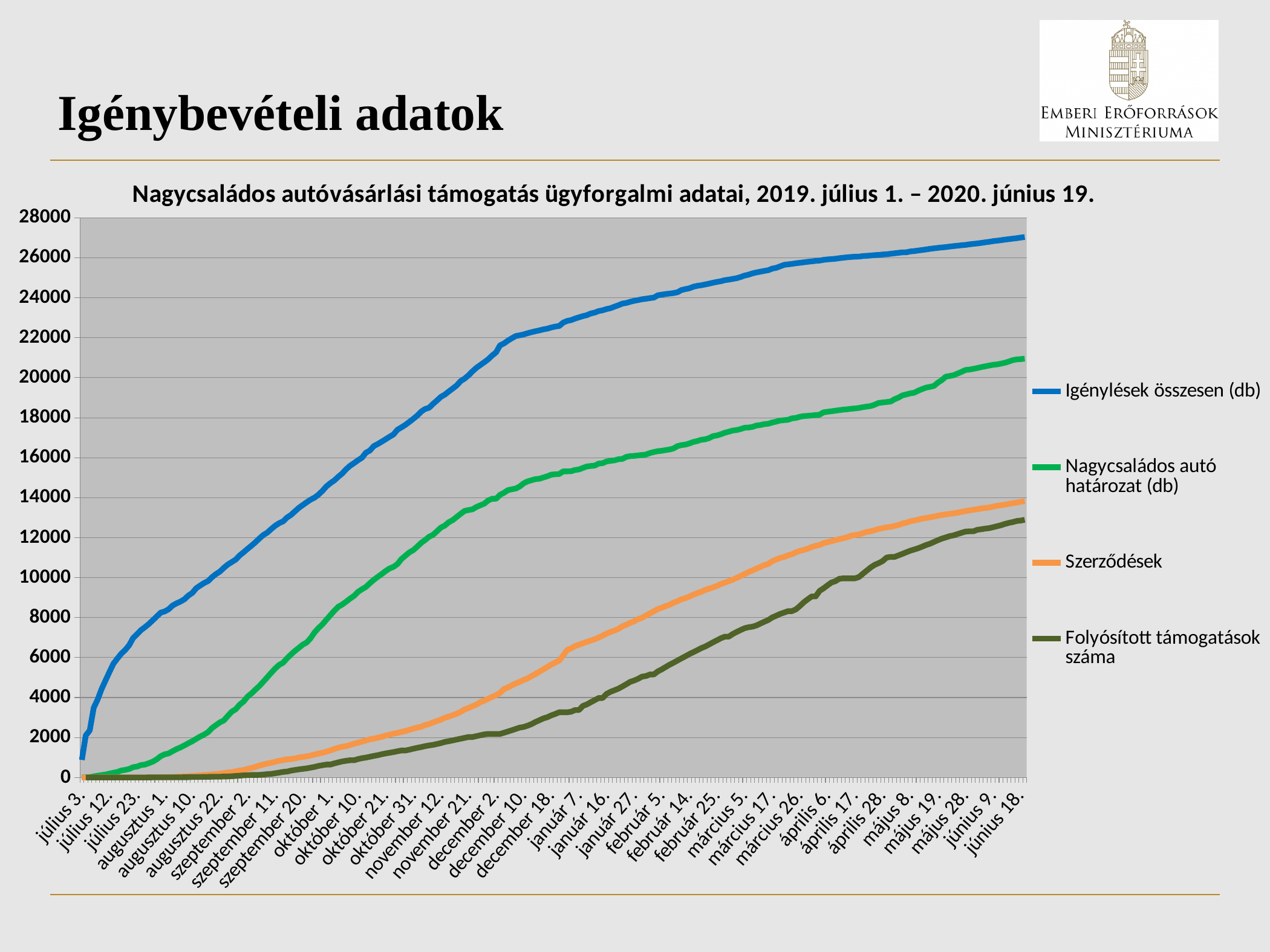
Is the value for Folyósított támogatások száma at január 7. greater or less than 6000? less Is the value for Igénylések összesen (db) at június 18. greater or less than 26000? greater What colour is the Szerződések line? orange What kind of chart is shown on the slide? line chart Does the Igénylések összesen (db) series rise or fall along the x axis? rise Is the value for Nagycsaládos autó határozat (db) at június 18. greater or less than 22000? less What is the title of the chart? Nagycsaládos autóvásárlási támogatás ügyforgalmi adatai, 2019. július 1. – 2020. június 19. Which series has the highest value at június 18.? Igénylések összesen (db) At december 2., which is larger: Igénylések összesen (db) or Nagycsaládos autó határozat (db)? Igénylések összesen (db) Which series has the lowest value at június 18.? Folyósított támogatások száma How many series does the legend list? 4